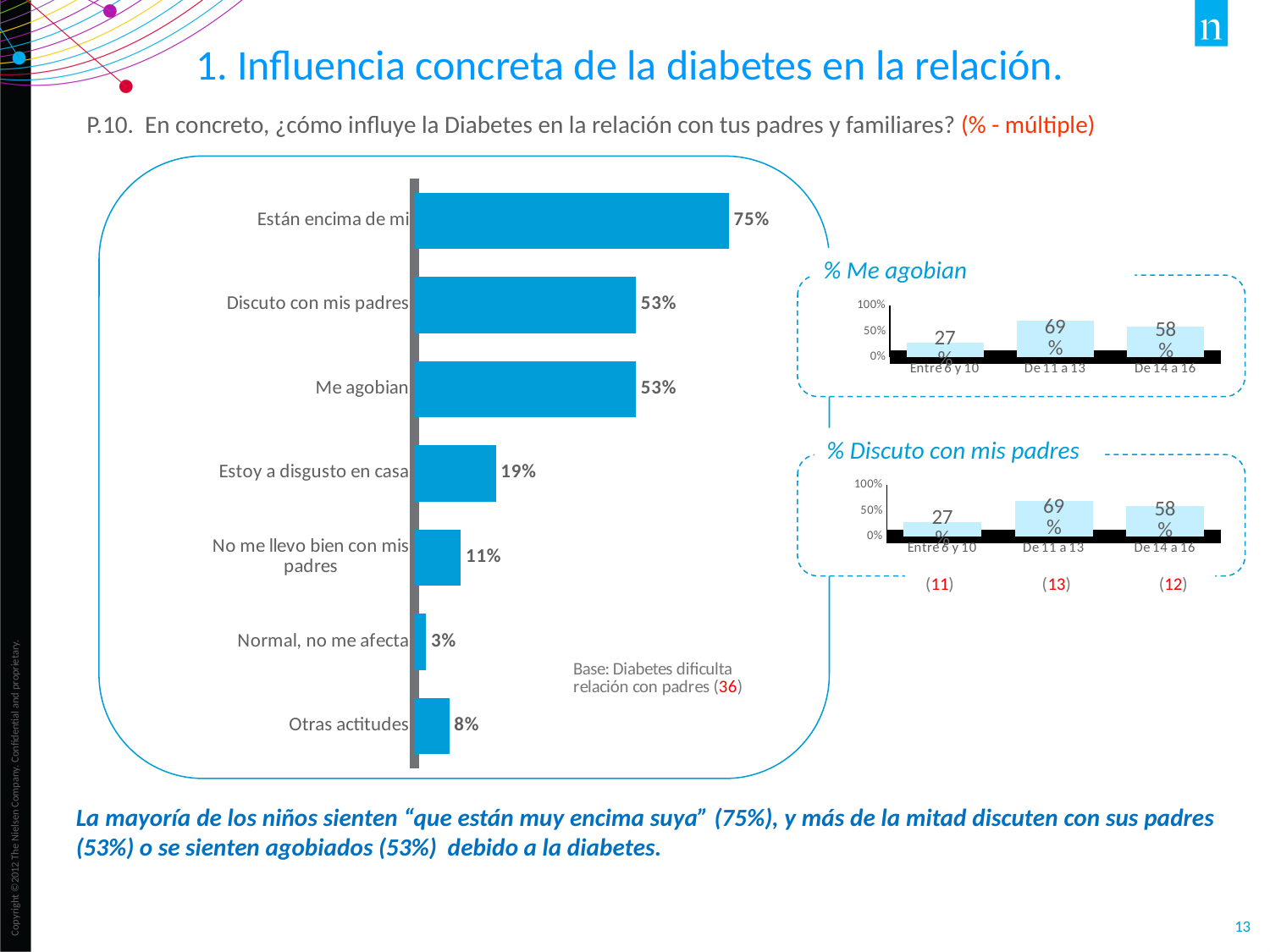
On the "% Discuto con mis padres" chart, which age group has the lowest value? Entre 6 y 10 On the large bar chart on the left, which category has the highest value? Están encima de mi What kind of chart is the large chart on the left? Bar chart On the large bar chart on the left, what is the value for "Están encima de mi"? 75% On the "% Me agobian" chart, how many age groups are shown? 3 On the large bar chart on the left, how many categories are shown? 7 On the "% Discuto con mis padres" chart, what is the difference between "De 11 a 13" and "De 14 a 16"? 11% On the large bar chart on the left, what is the difference between "Están encima de mi" and "Discuto con mis padres"? 22% On the large bar chart on the left, what is the value for "Estoy a disgusto en casa"? 19% On the large bar chart on the left, which category has the lowest value? Normal, no me afecta On the "% Me agobian" chart, what is the value for "De 11 a 13"? 69% On the large bar chart on the left, which is larger: "No me llevo bien con mis padres" or "Otras actitudes"? No me llevo bien con mis padres